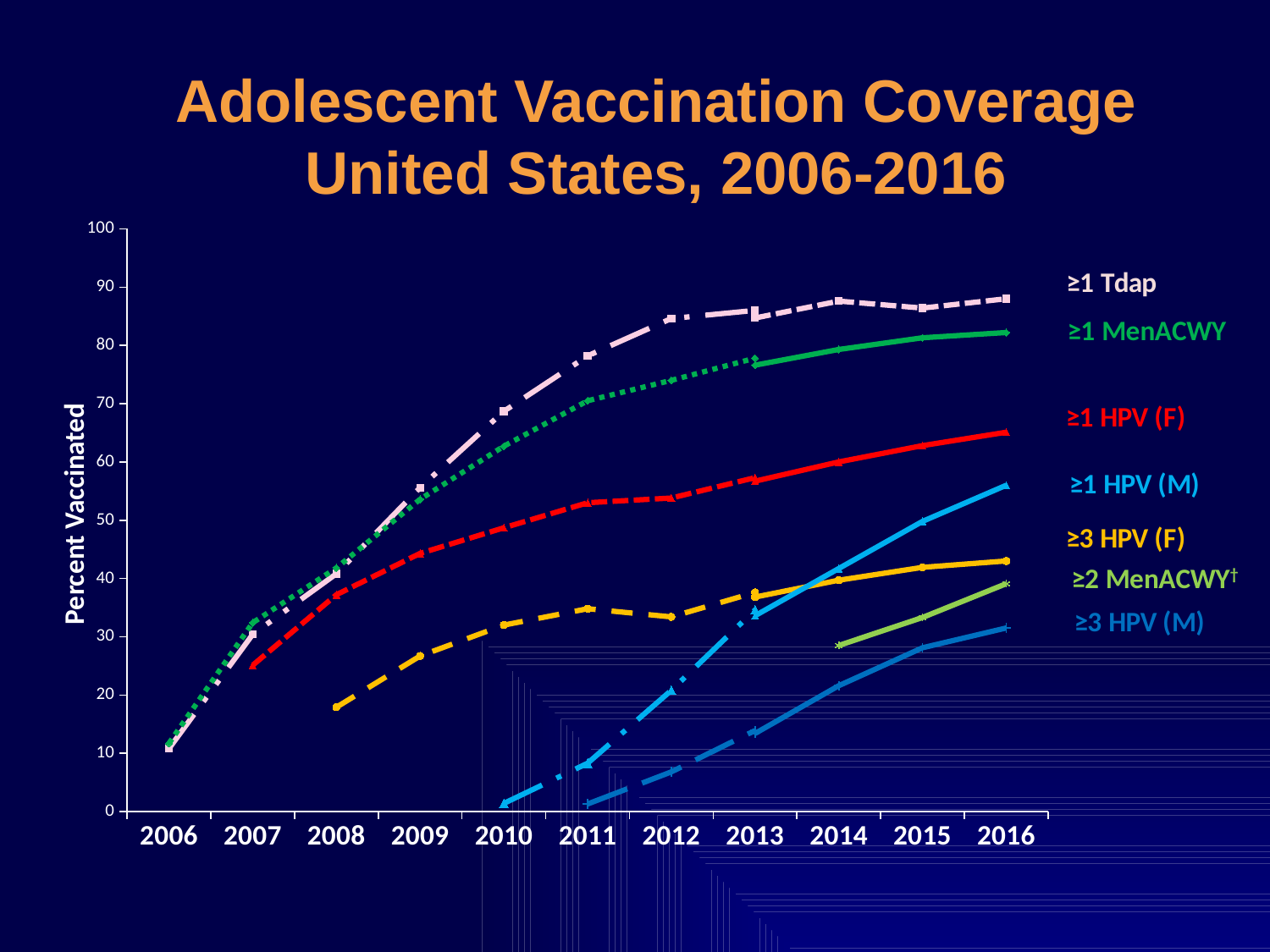
What is the label of the y axis? Percent Vaccinated What kind of chart is shown on the slide? line chart Which series has the highest value in 2016? ≥1 Tdap How many years are shown along the x axis? 11 In 2016, which is larger: ≥1 HPV (F) or ≥1 HPV (M)? ≥1 HPV (F) Is the value for ≥1 HPV (F) in 2016 greater or less than 60? greater Is the value for ≥1 HPV (M) in 2010 greater or less than 10? less How many series does the legend list? 7 Which series has the lowest value in 2016? ≥3 HPV (M) Does the ≥1 Tdap series rise or fall from 2006 to 2016? rise Is the value for ≥1 Tdap in 2016 greater or less than 80? greater